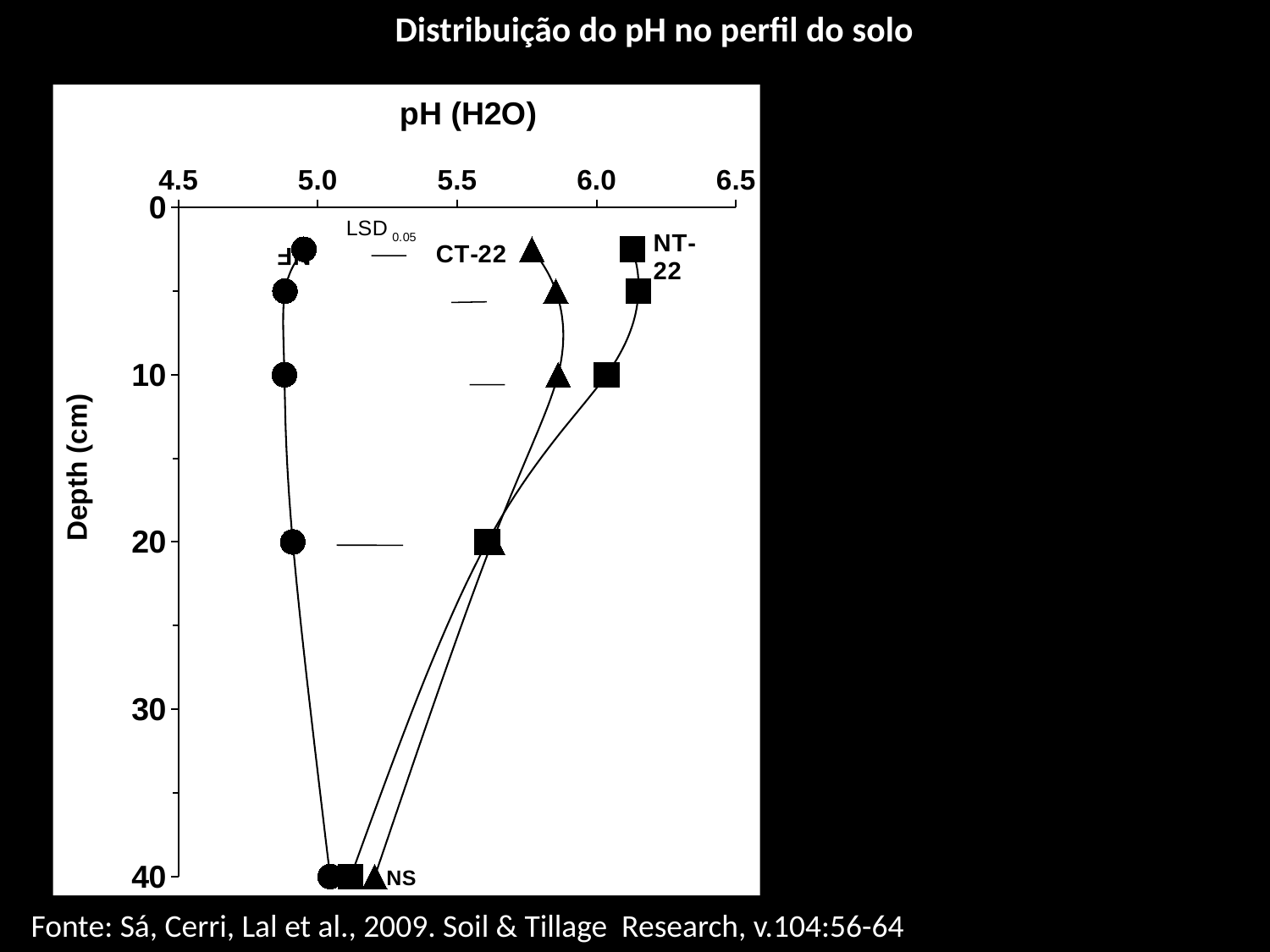
Is the pH value for the series plotted with circle markers at a depth of 10 cm greater or less than 5.0? less Is the pH value for CT-22 at a depth of 10 cm greater or less than 5.5? greater At a depth of 5 cm, which series has the highest pH? NT-22 Does the pH of the NT-22 series rise or fall as depth increases from 5 cm to 40 cm? fall What is the label of the horizontal axis of the chart? pH (H2O) What kind of chart is shown on the slide? line chart Is the pH value for NT-22 at a depth of 10 cm greater or less than 5.5? greater What is the title of the chart on the slide? Distribuição do pH no perfil do solo At a depth of 20 cm, which series has the lowest pH? the series with circle markers At a depth of 10 cm, which series has the higher pH, NT-22 or CT-22? NT-22 How many depth points are plotted for the NT-22 series? 5